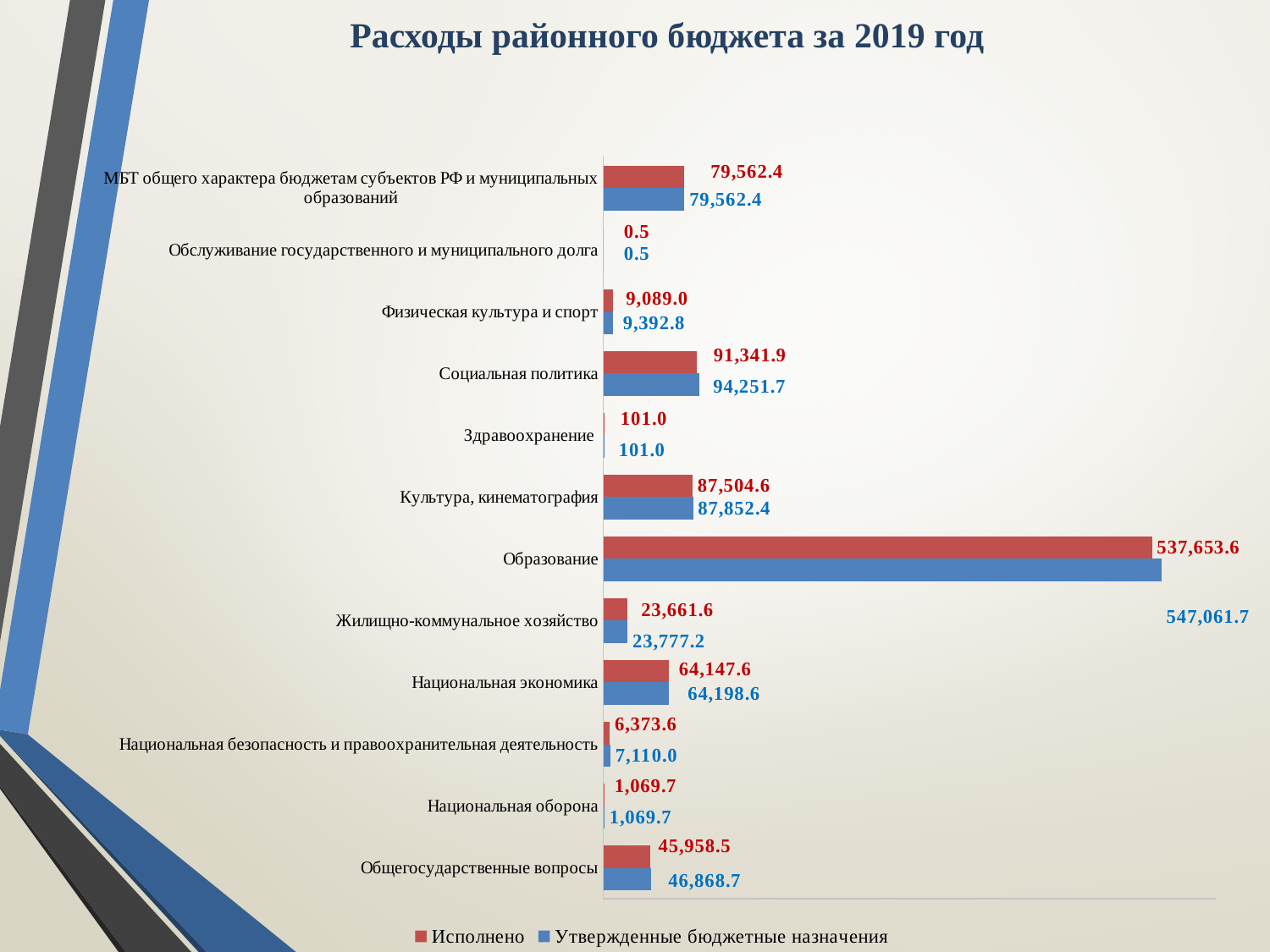
Which category has the lowest Утвержденные бюджетные назначения value? Обслуживание государственного и муниципального долга Which is larger for Национальная безопасность и правоохранительная деятельность: Исполнено or Утвержденные бюджетные назначения? Утвержденные бюджетные назначения What is the Исполнено value for Образование? 537,653.6 Which category has the highest Исполнено value? Образование What is the title of the chart? Расходы районного бюджета за 2019 год How many categories are shown on the chart? 12 What is the difference between Утвержденные бюджетные назначения and Исполнено for Образование? 9,408.1 What is the difference between Утвержденные бюджетные назначения and Исполнено for Социальная политика? 2,909.8 How many series does the legend list? 2 What is the Утвержденные бюджетные назначения value for Социальная политика? 94,251.7 What type of chart is shown on the slide? Bar chart What is the Исполнено value for Общегосударственные вопросы? 45,958.5